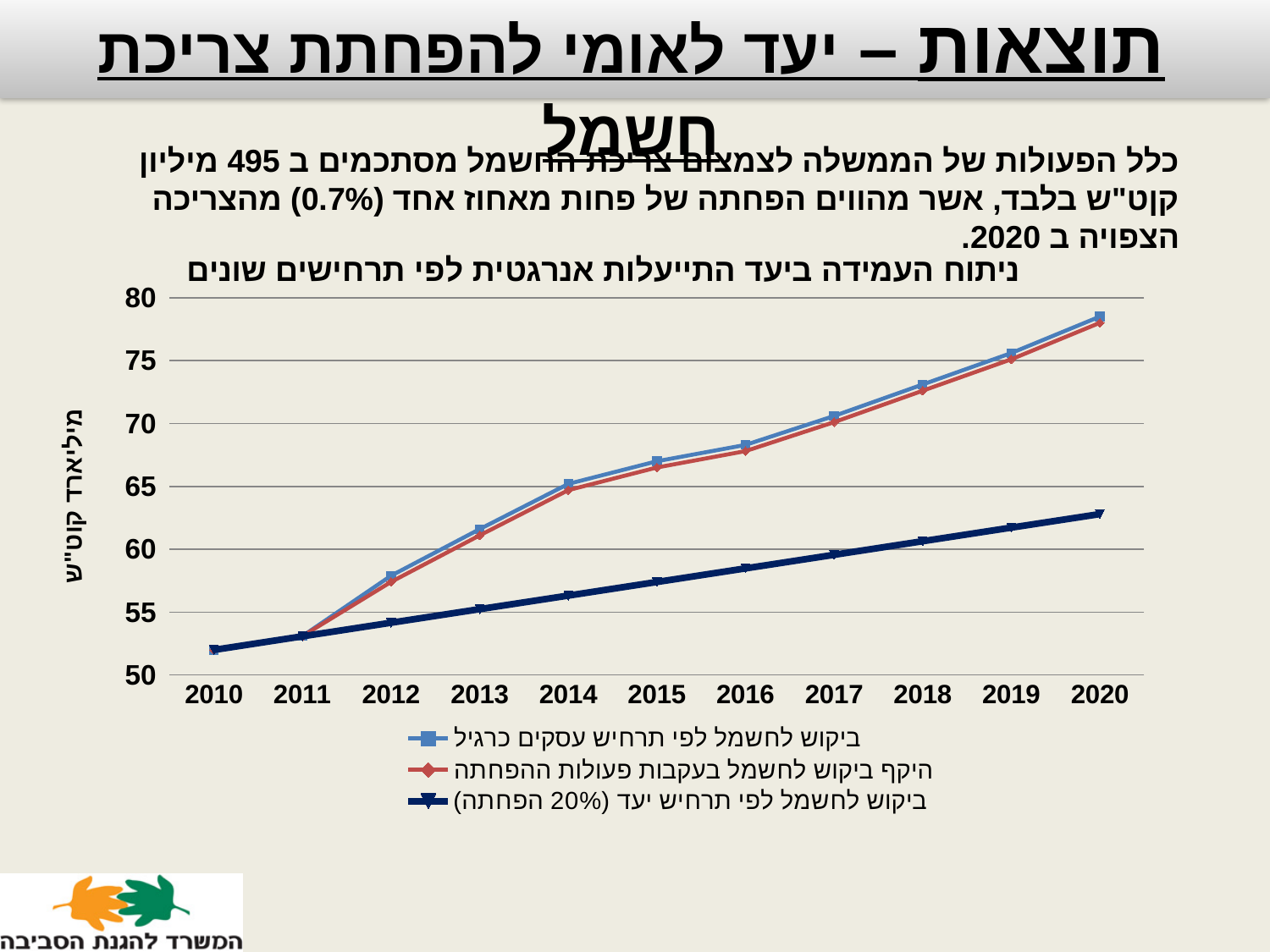
In 2020, which is larger: the value for 'ביקוש לחשמל לפי תרחיש עסקים כרגיל' or the value for 'ביקוש לחשמל לפי תרחיש יעד (20% הפחתה)'? ביקוש לחשמל לפי תרחיש עסקים כרגיל How many series does the legend list? 3 Is the 2020 value for 'ביקוש לחשמל לפי תרחיש עסקים כרגיל' greater or less than 75? greater In which year is the value for 'היקף ביקוש לחשמל בעקבות פעולות ההפחתה' highest? 2020 Is the 2020 value for 'ביקוש לחשמל לפי תרחיש יעד (20% הפחתה)' greater or less than 65? less Is the 2016 value for 'ביקוש לחשמל לפי תרחיש יעד (20% הפחתה)' greater or less than 60? less Do the values of the series 'ביקוש לחשמל לפי תרחיש עסקים כרגיל' rise or fall from 2010 to 2020? rise What is the label on the y axis of the chart? מיליארד קוט"ש What kind of chart is shown on the slide? line chart In which year is the value for 'ביקוש לחשמל לפי תרחיש יעד (20% הפחתה)' lowest? 2010 How many years are plotted along the x axis? 11